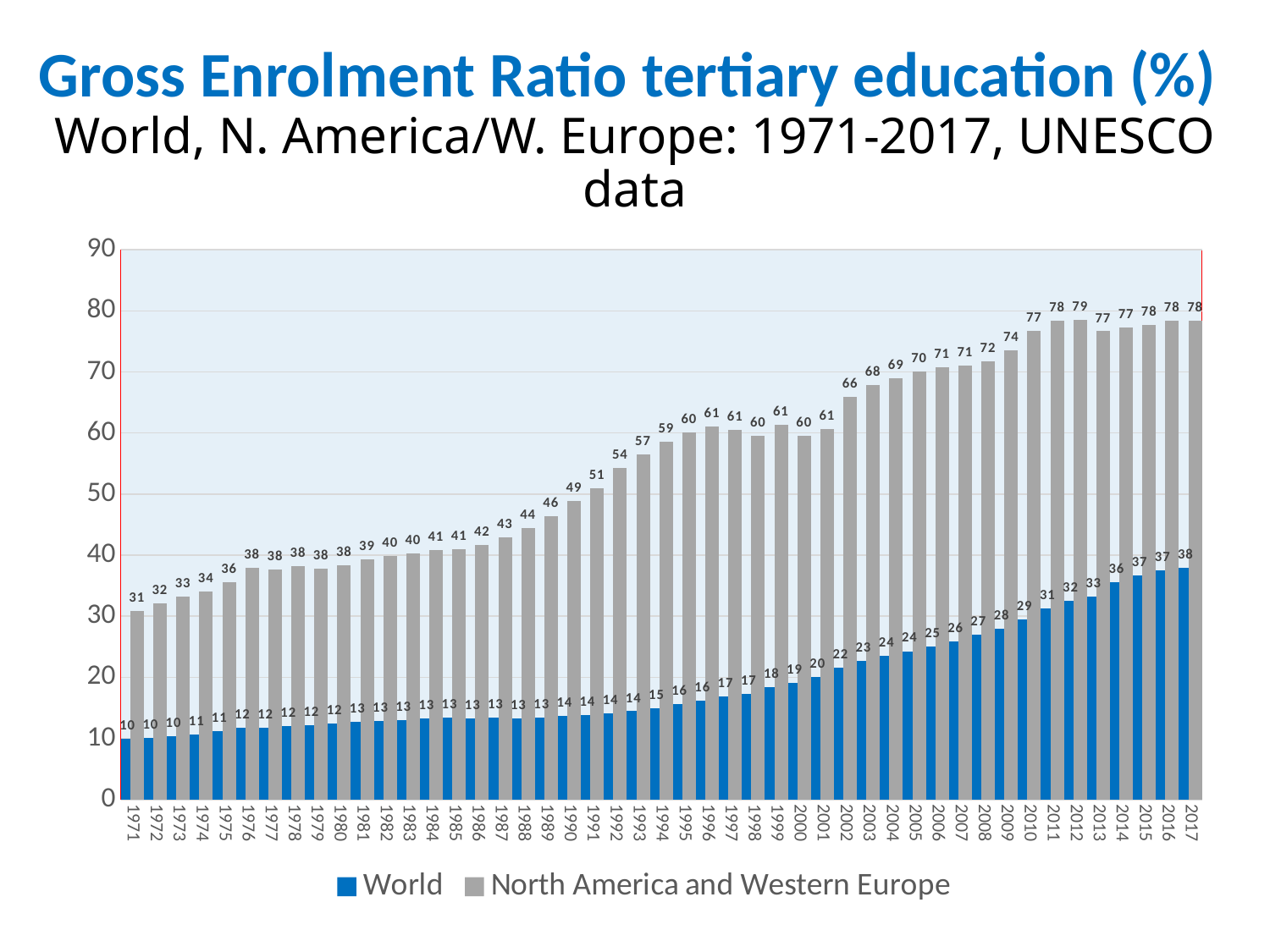
In 2000, which series has the larger value, World or North America and Western Europe? North America and Western Europe What kind of chart is shown on the slide? Bar chart What is the difference between the North America and Western Europe value and the World value in 2017? 40 What is the Gross Enrolment Ratio for World in 2000? 19 In which year is the North America and Western Europe value lowest? 1971 What is the Gross Enrolment Ratio for North America and Western Europe in 1971? 31 What is the Gross Enrolment Ratio for World in 2017? 38 What colour are the bars for the World series? Blue How many series does the legend list? 2 How many years are shown on the x axis? 47 Does the World series rise or fall from 1971 to 2017? Rise In which year is the North America and Western Europe value highest? 2012